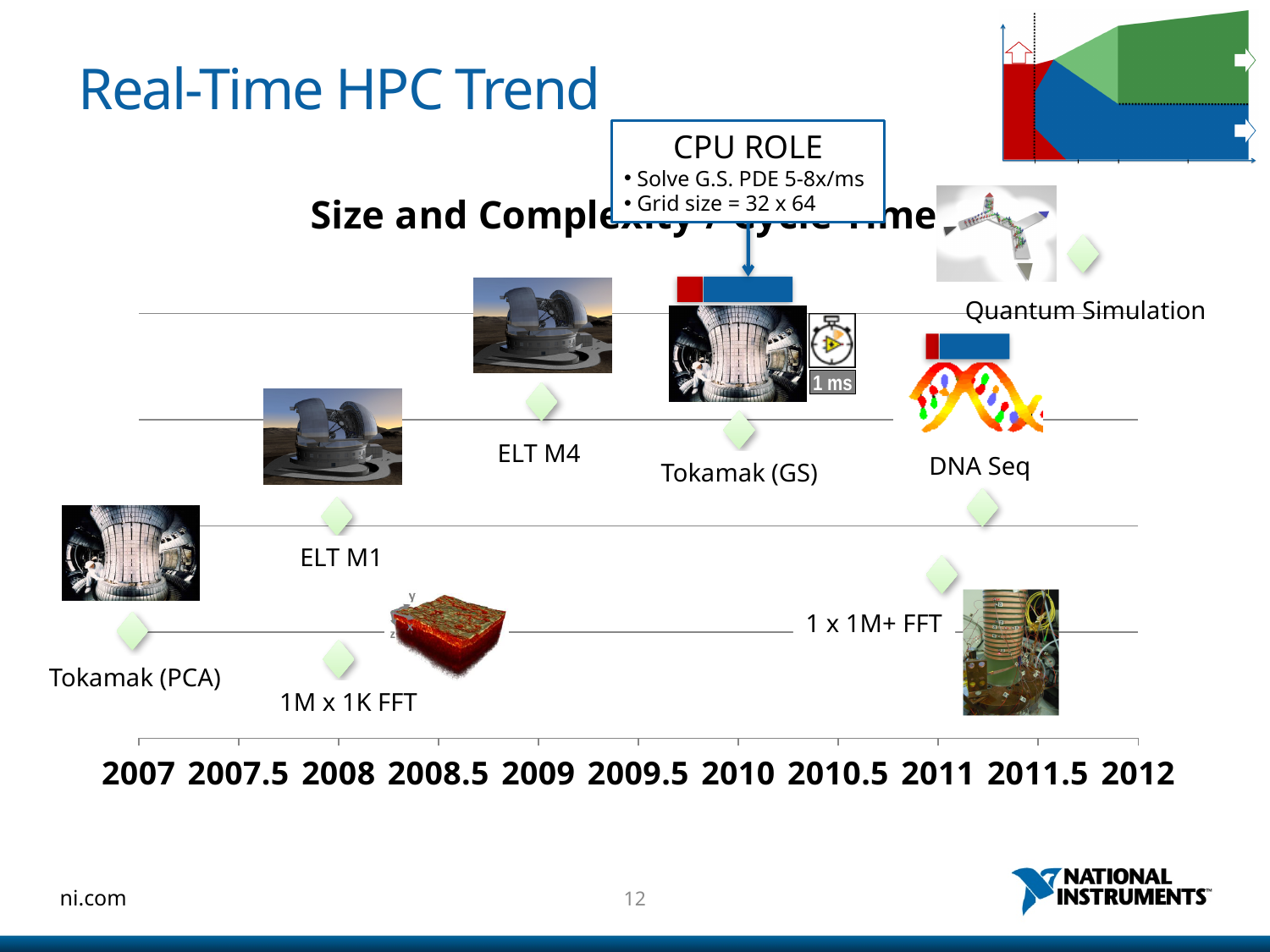
Which is plotted higher on the chart, ELT M1 or ELT M4? ELT M4 At which year on the x axis is the Tokamak (PCA) point plotted? 2007 At which year on the x axis is the Tokamak (GS) point plotted? 2010 How many labelled data points (diamond markers) are plotted on the chart? 8 At which year on the x axis is the ELT M1 point plotted? 2008 At which year on the x axis is the ELT M4 point plotted? 2009 Do the plotted points generally rise or fall as the years increase along the x axis? rise Which labelled point is plotted highest on the chart? Quantum Simulation Is the x-axis position of the Quantum Simulation point greater or less than 2011.5? greater What kind of chart is shown on the slide? scatter chart Which labelled point is plotted lowest on the chart? 1M x 1K FFT